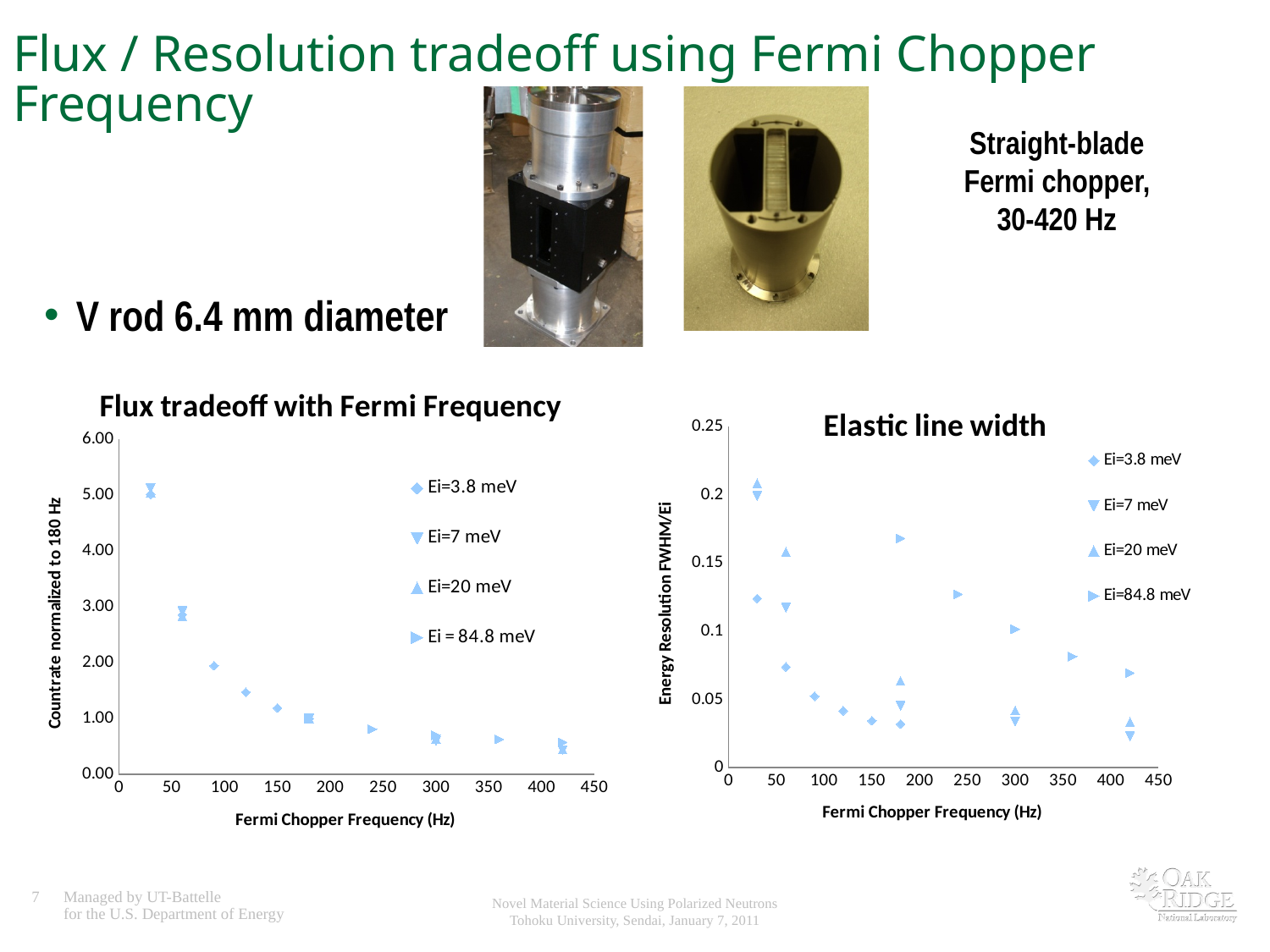
In the 'Elastic line width' chart, is the Ei=84.8 meV value at 240 Hz greater or less than 0.1? greater In the 'Flux tradeoff with Fermi Frequency' chart, which has the larger countrate: the point at 30 Hz or the point at 60 Hz? 30 Hz In the 'Elastic line width' chart, does the energy resolution for the Ei=84.8 meV series rise or fall as the frequency increases from 180 Hz to 420 Hz? fall In the 'Flux tradeoff with Fermi Frequency' chart, at which frequency is the countrate highest? 30 Hz What kind of chart is the 'Flux tradeoff with Fermi Frequency' chart? scatter chart In the 'Flux tradeoff with Fermi Frequency' chart, what is the label of the y axis? Countrate normalized to 180 Hz In the 'Elastic line width' chart, is the Ei=3.8 meV value at 150 Hz greater or less than 0.05? less In the 'Flux tradeoff with Fermi Frequency' chart, is the countrate at 300 Hz greater or less than 1.00? less How many series does the legend of the 'Elastic line width' chart list? 4 In the 'Elastic line width' chart, what is the label of the x axis? Fermi Chopper Frequency (Hz) In the 'Flux tradeoff with Fermi Frequency' chart, does the countrate rise or fall as the Fermi chopper frequency increases? fall